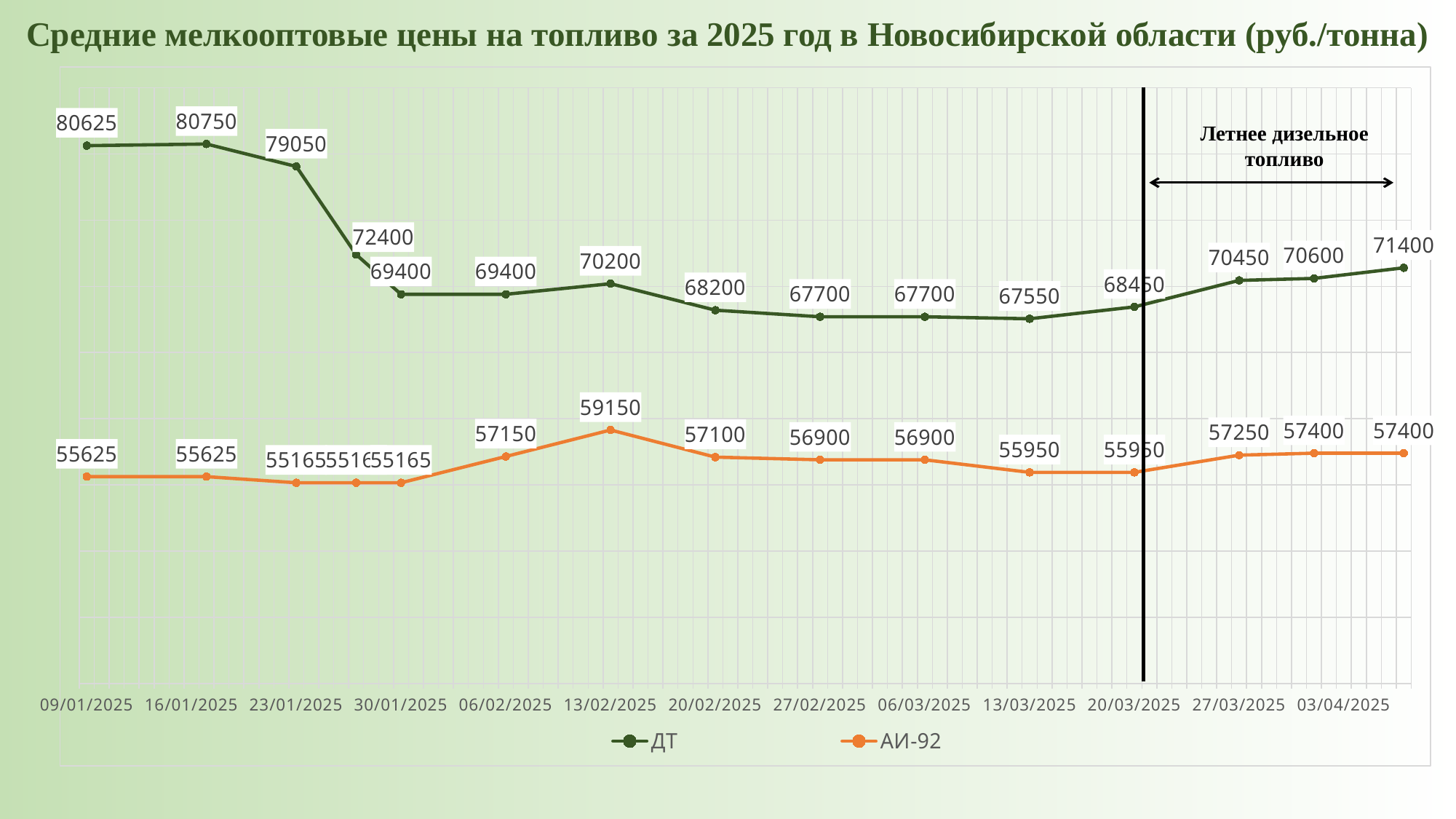
On which date is the АИ-92 price highest? 13/02/2025 How many series does the legend list? 2 What is the АИ-92 price on 20/03/2025? 55950 On which date is the ДТ price highest? 16/01/2025 What kind of chart is shown on the slide? Line chart What is the АИ-92 price on 13/02/2025? 59150 Does the ДТ price rise or fall from 09/01/2025 to 13/03/2025? Fall Which is larger, the ДТ price on 20/02/2025 or on 27/02/2025? 20/02/2025 What is the difference between the ДТ price and the АИ-92 price on 13/02/2025? 11050 On which date is the ДТ price lowest? 13/03/2025 What is the ДТ price on 09/01/2025? 80625